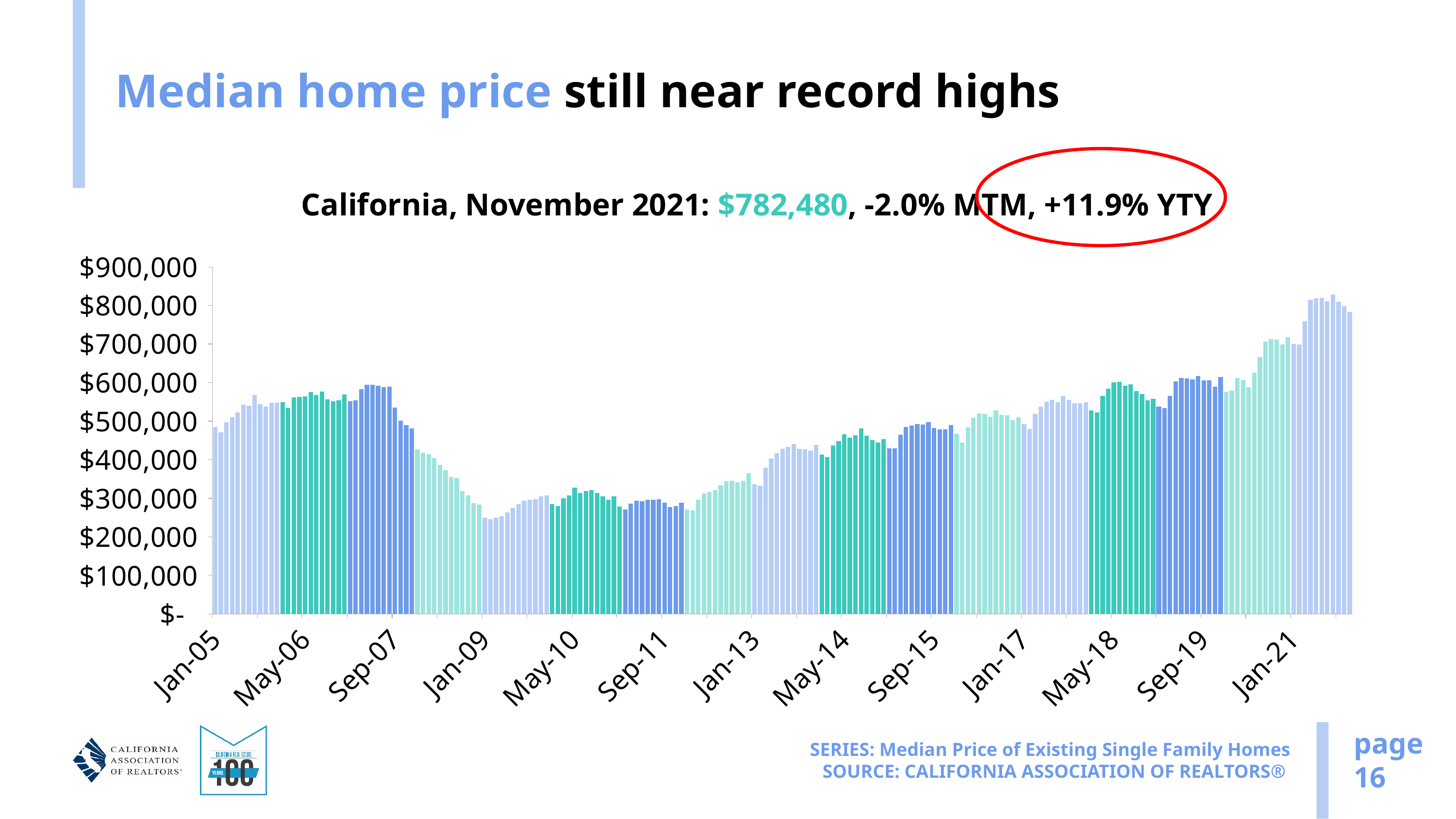
What is the month-to-month (MTM) change in the median home price stated on the slide? -2.0% Do the values generally rise or fall between Jan-09 and Jan-21? rise Is the value for Sep-15 greater or less than $600,000? less What kind of chart is shown on the slide? bar chart Is the value for Jan-09 greater or less than $300,000? less What was the California median home price in November 2021? $782,480 Which is larger, the value for Sep-07 or the value for Sep-11? Sep-07 Which is larger, the value for Jan-21 or the value for Jan-17? Jan-21 Is the value for Sep-07 greater or less than $500,000? greater What is the year-to-year (YTY) change in the median home price stated on the slide? +11.9%